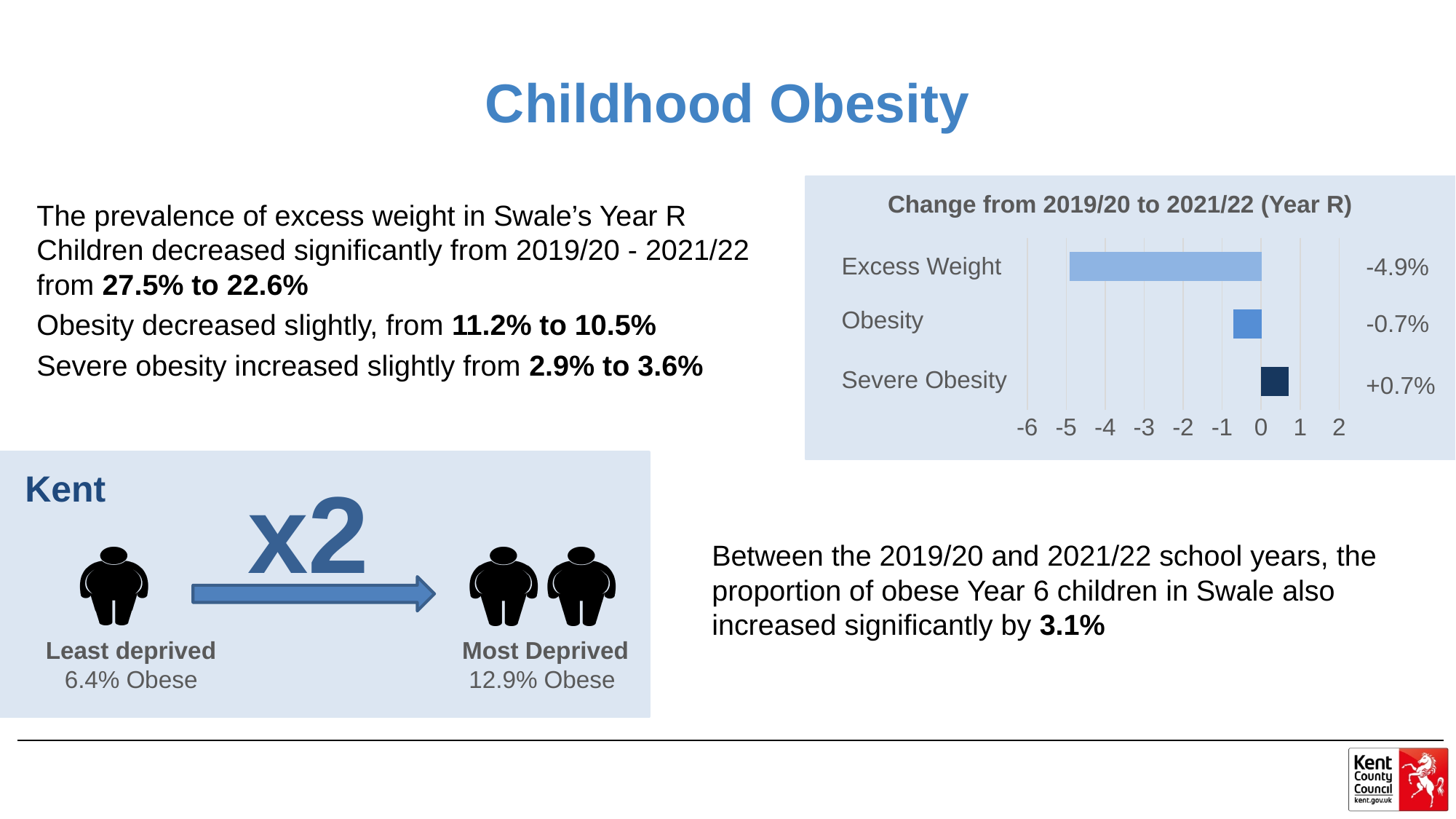
What kind of chart is shown on the slide? bar chart Which category in the chart is the only one with a positive value? Severe Obesity What is the value for Severe Obesity in the chart? +0.7% Which is larger in the chart, the value for Obesity or the value for Severe Obesity? Severe Obesity How many categories are shown in the chart? 3 What is the value for Excess Weight in the chart? -4.9% Which category in the chart has the lowest value? Excess Weight Is the value for Excess Weight greater or less than -4? less Which category in the chart has the highest value? Severe Obesity What is the value for Obesity in the chart? -0.7% What is the difference between the values for Excess Weight and Obesity in the chart? 4.2 percentage points What is the title of the chart on the slide? Change from 2019/20 to 2021/22 (Year R)